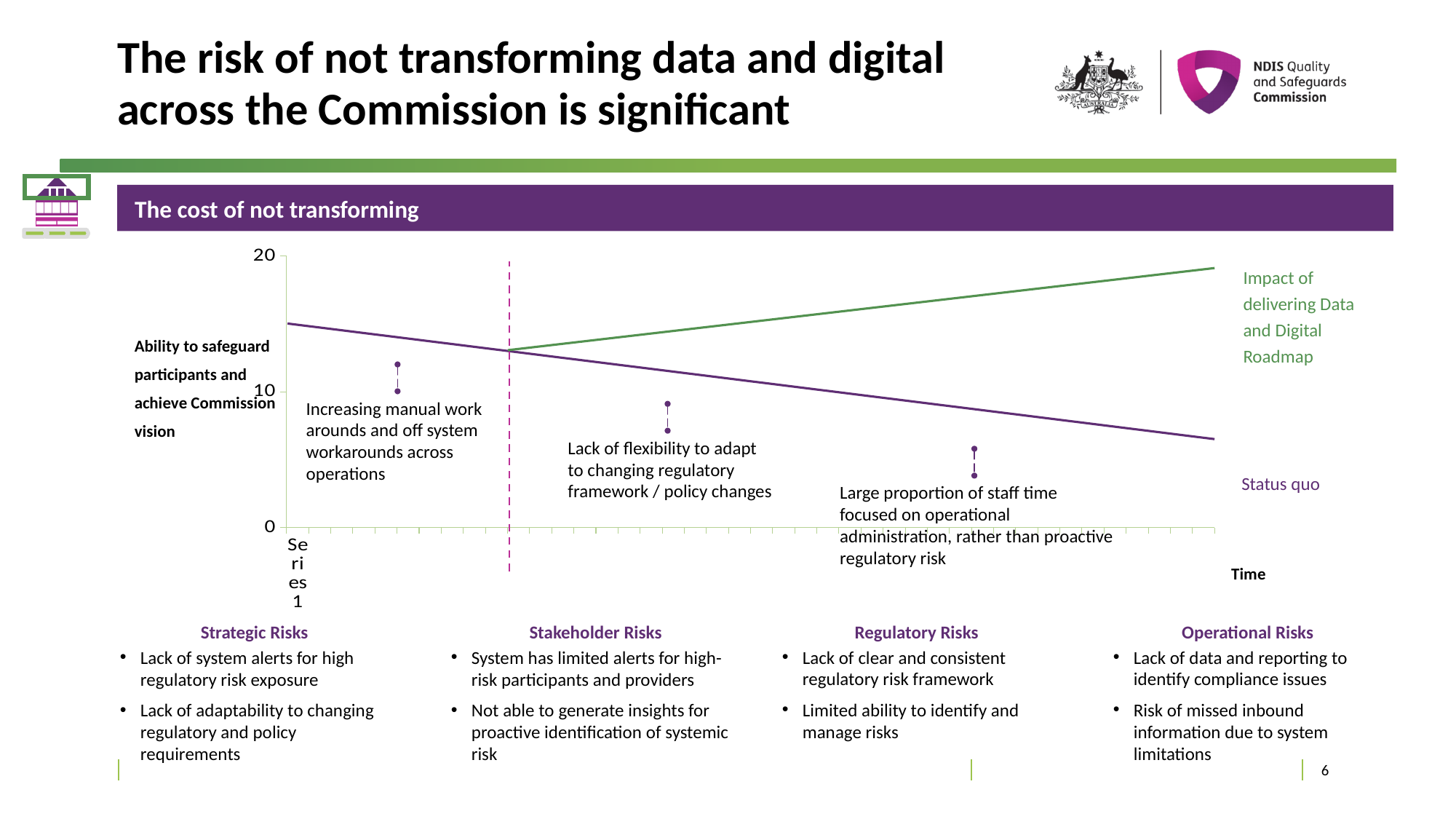
How many lines are plotted on the chart? 2 At the right-hand end of the chart, is the Status quo line greater or less than 10? less Is the 'Impact of delivering Data and Digital Roadmap' line greater or less than 20 at its right-hand end? less What kind of chart is shown on the slide? line chart Does the Status quo line rise or fall as time moves along the x axis? fall What is the label on the chart's x axis? Time At the right-hand end of the chart, is the 'Impact of delivering Data and Digital Roadmap' line greater or less than 10? greater What is the label on the chart's y axis? Ability to safeguard participants and achieve Commission vision Does the 'Impact of delivering Data and Digital Roadmap' line rise or fall along the x axis? rise At the right-hand end of the chart, which line is higher: Status quo or Impact of delivering Data and Digital Roadmap? Impact of delivering Data and Digital Roadmap